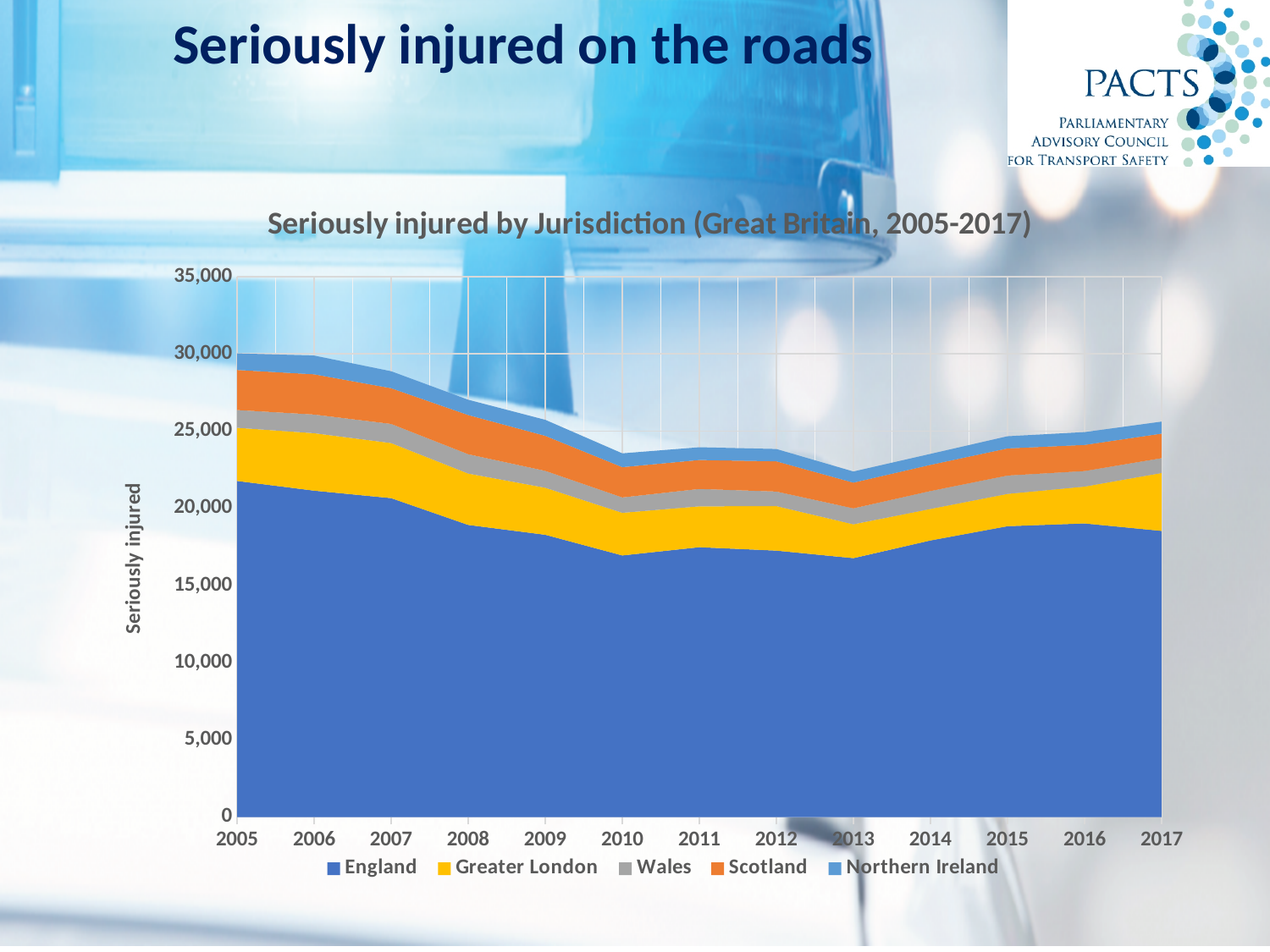
Is the total of all jurisdictions in 2007 greater or less than 25,000? greater Which jurisdiction accounts for the largest share of seriously injured in every year? England What kind of chart is shown on the slide? Stacked area chart What is the title of the chart? Seriously injured by Jurisdiction (Great Britain, 2005-2017) Which series is shown at the bottom of the stack in dark blue? England Is the value for England in 2013 greater or less than 20,000? less How many series does the legend list? 5 In which year is the total number of seriously injured highest? 2005 Do the total seriously injured values rise or fall from 2005 to 2013? fall Is the value for England in 2005 greater or less than 20,000? greater How many years are plotted along the x axis? 13